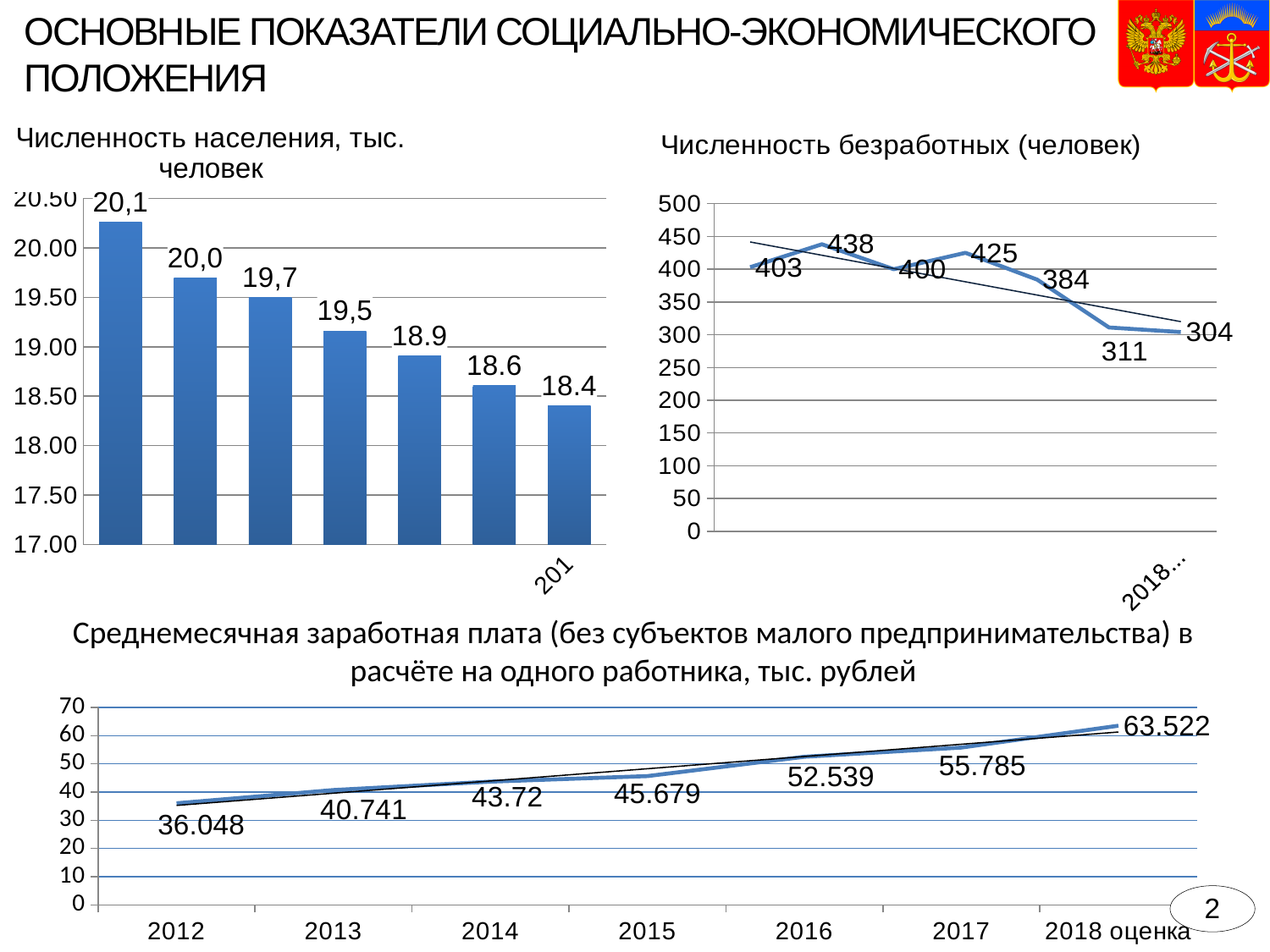
In the 'Среднемесячная заработная плата' chart, what is the difference between the value for 2018 оценка and the value for 2012? 27.474 In the 'Численность населения, тыс. человек' chart, what is the value of the first (leftmost) bar? 20,1 In the 'Численность безработных (человек)' chart, what is the lowest value shown? 304 What kind of chart is the 'Численность населения, тыс. человек' chart? bar chart Do the values in the 'Численность населения, тыс. человек' chart rise or fall from left to right? fall In the 'Численность безработных (человек)' chart, what is the difference between the second point (438) and the last point (304)? 134 What kind of chart is the 'Численность безработных (человек)' chart? line chart In the 'Численность населения, тыс. человек' chart, what is the value of the last (rightmost) bar? 18.4 In the 'Среднемесячная заработная плата' chart, which is larger, the value for 2016 or the value for 2014? 2016 In the 'Численность безработных (человек)' chart, what is the highest value shown? 438 How many bars are in the 'Численность населения, тыс. человек' chart? 7 In the 'Среднемесячная заработная плата' chart, what is the value for 2015? 45.679